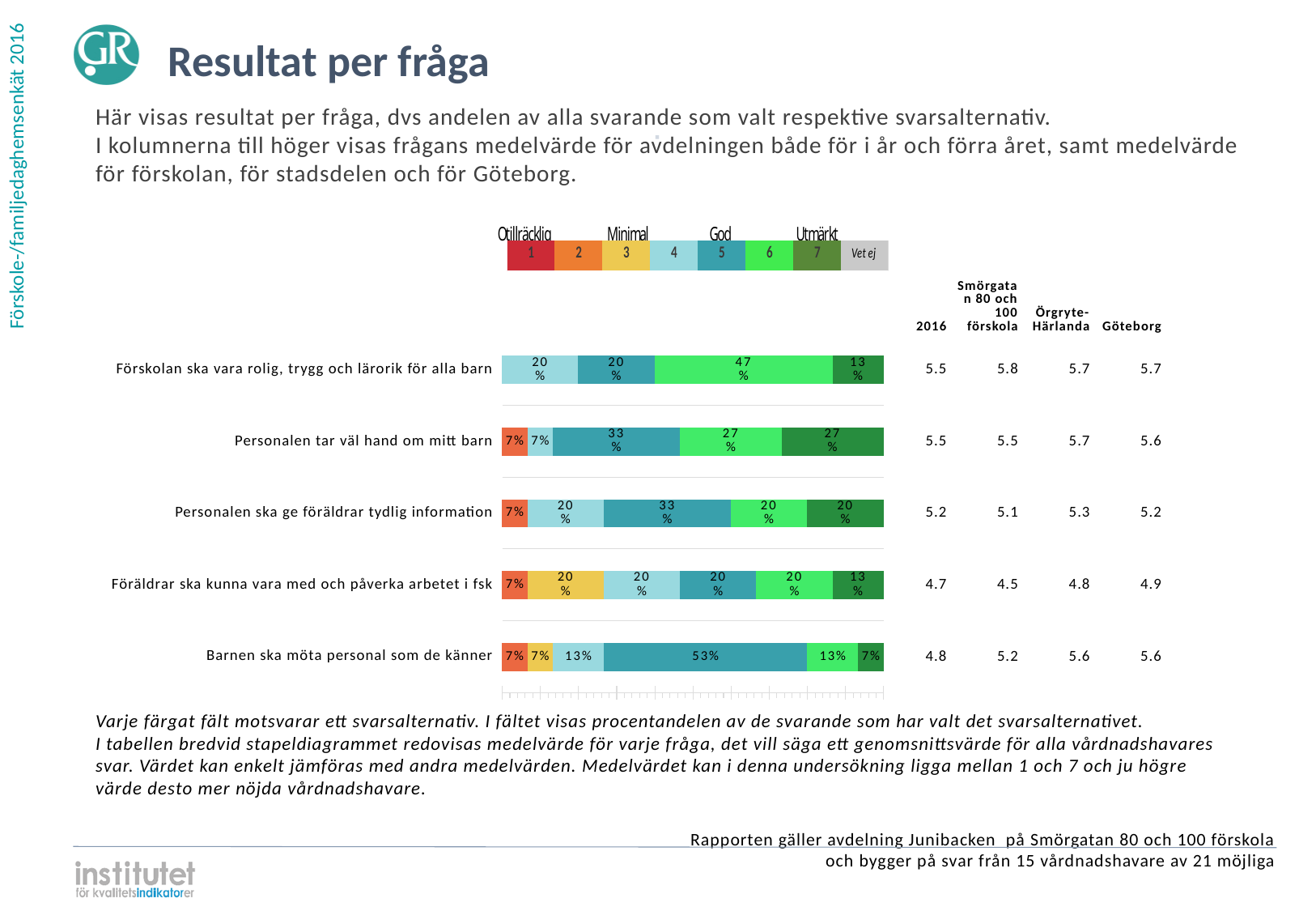
What percentage of respondents chose alternative 3 for 'Föräldrar ska kunna vara med och påverka arbetet i fsk'? 20% What percentage of respondents chose alternative 5 for 'Barnen ska möta personal som de känner'? 53% What percentage of respondents chose alternative 7 for 'Personalen tar väl hand om mitt barn'? 27% For 'Barnen ska möta personal som de känner', what is the difference between the share for alternative 5 and the share for alternative 4? 40% For 'Personalen tar väl hand om mitt barn', which is larger: the share for alternative 5 or the share for alternative 6? Alternative 5 How many response alternatives does the legend above the chart list? 8 Which label in the legend corresponds to the highest rating, 7? Utmärkt What percentage of respondents chose alternative 6 for 'Förskolan ska vara rolig, trygg och lärorik för alla barn'? 47% Which response alternative has the largest share for 'Personalen ska ge föräldrar tydlig information'? 5 How many questions (categories) are plotted in the bar chart? 5 What is the combined share of alternatives 6 and 7 for 'Förskolan ska vara rolig, trygg och lärorik för alla barn'? 60% What kind of chart is shown on the slide? Stacked bar chart